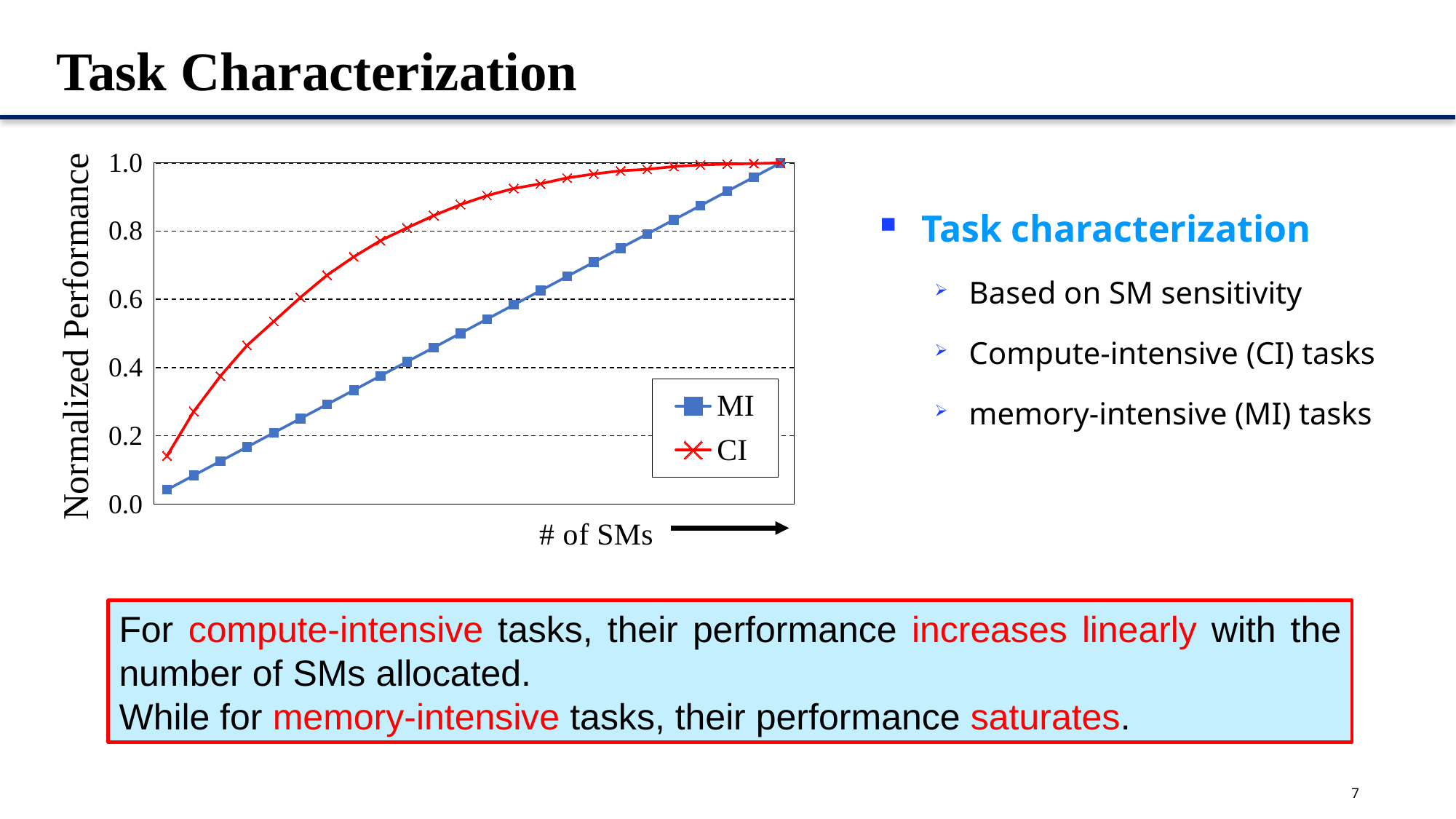
What normalized performance value does the CI series reach at its rightmost point? 1.0 Does the CI series rise or fall as the number of SMs increases? rise At the leftmost point on the x axis, which series has the higher normalized performance, MI or CI? CI What normalized performance value does the MI series reach at its rightmost point? 1.0 How many series does the chart legend list? 2 Is the normalized performance of the MI series at its leftmost point greater or less than 0.2? less What are the two series named in the chart legend? MI and CI Is the normalized performance of the MI series at the midpoint of the x axis greater or less than 0.8? less What is the label of the chart's vertical axis? Normalized Performance What kind of chart is shown on the slide? line chart Is the normalized performance of the CI series at the midpoint of the x axis greater or less than 0.8? greater Does the MI series rise or fall as the number of SMs increases? rise